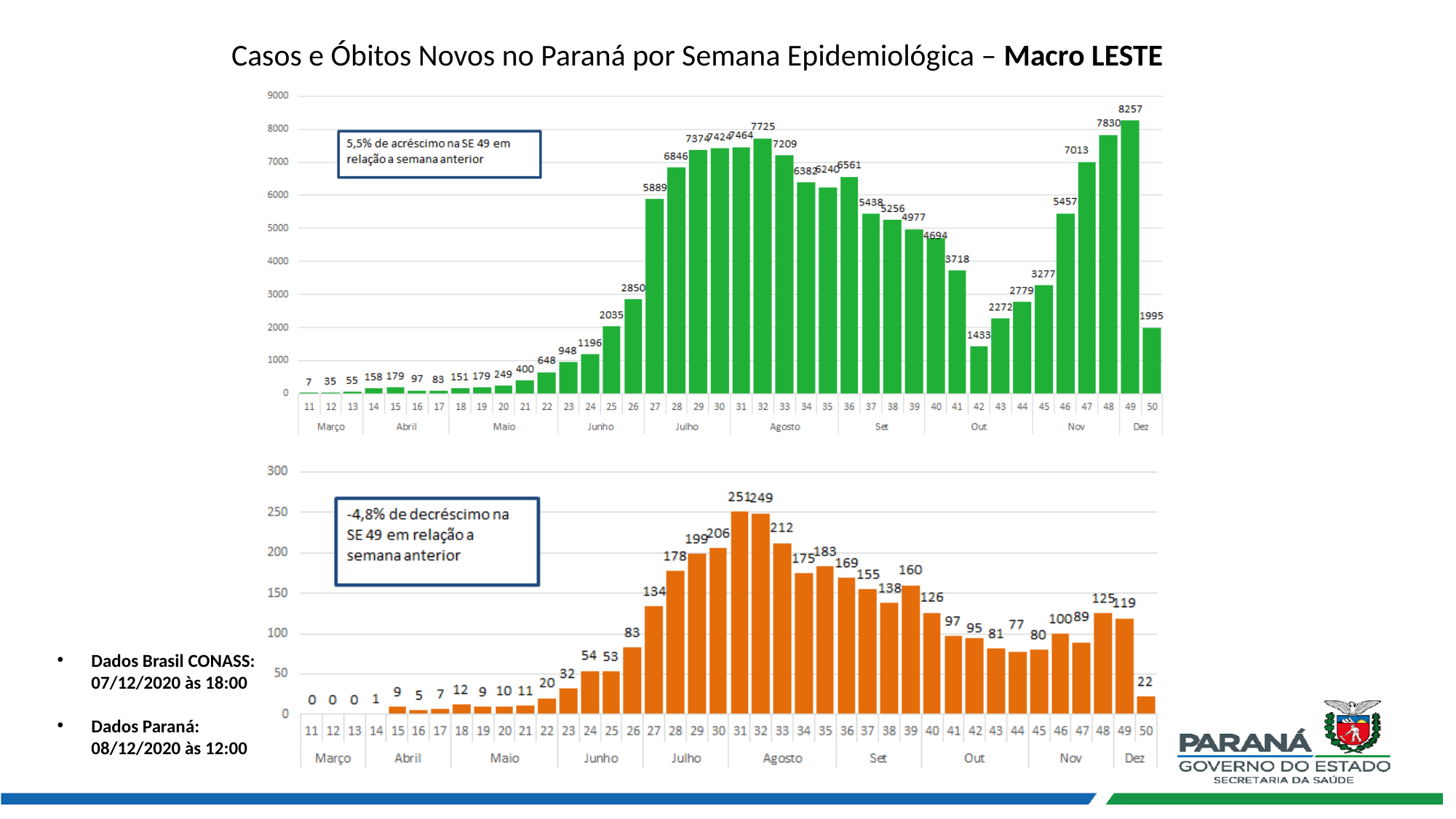
In the top (green) chart, what is the value for week 49? 8257 In the bottom (orange) chart, what is the difference between the values for week 33 and week 34? 37 How many weeks (bars) are plotted in the top (green) chart? 40 In the bottom (orange) chart, what is the value for week 31? 251 In the top (green) chart, which week has the highest value? 49 In the top (green) chart, what is the value for week 42? 1433 In the top (green) chart, what is the difference between the values for week 49 and week 48? 427 In the bottom (orange) chart, which is larger, the value for week 48 or the value for week 49? week 48 In the top (green) chart, which week has the lowest value? 11 In the top (green) chart, do the values rise or fall from week 42 to week 49? rise In the bottom (orange) chart, which week has the highest value? 31 What type of chart is the bottom (orange) chart? bar chart